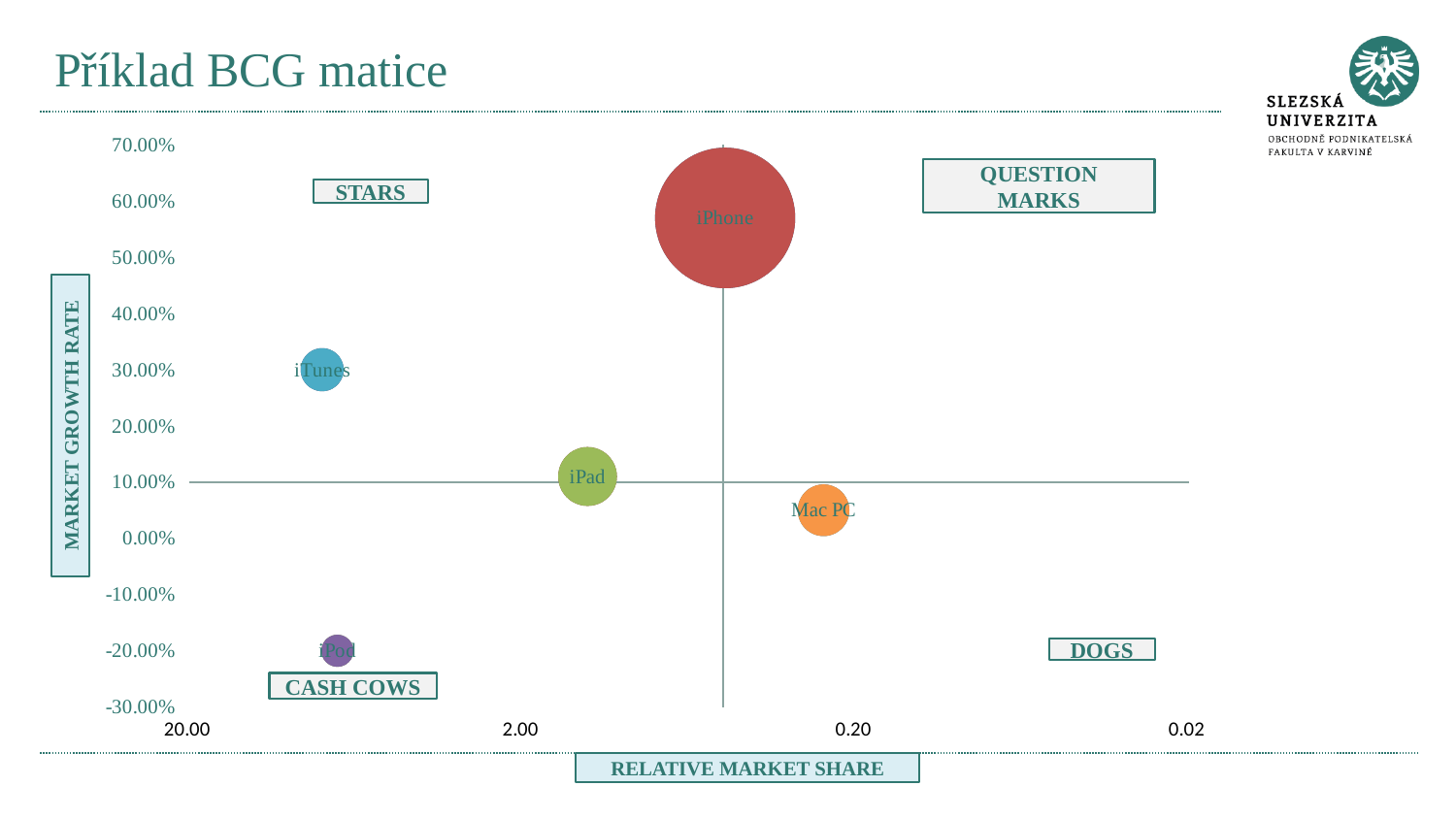
Which product has the higher market growth rate, iTunes or iPad? iTunes Is the market growth rate for iTunes greater or less than 20.00%? greater Is the market growth rate for iPhone greater or less than 50.00%? greater What kind of chart is shown on the slide? bubble chart What is the label of the horizontal axis of the chart? RELATIVE MARKET SHARE Which product has the higher market growth rate, Mac PC or iPhone? iPhone How many products are plotted as bubbles on the chart? 5 Which product is represented by the largest bubble on the chart? iPhone Is the market growth rate for Mac PC greater or less than 10.00%? less Which product has the lowest market growth rate? iPod Which product has the highest market growth rate? iPhone